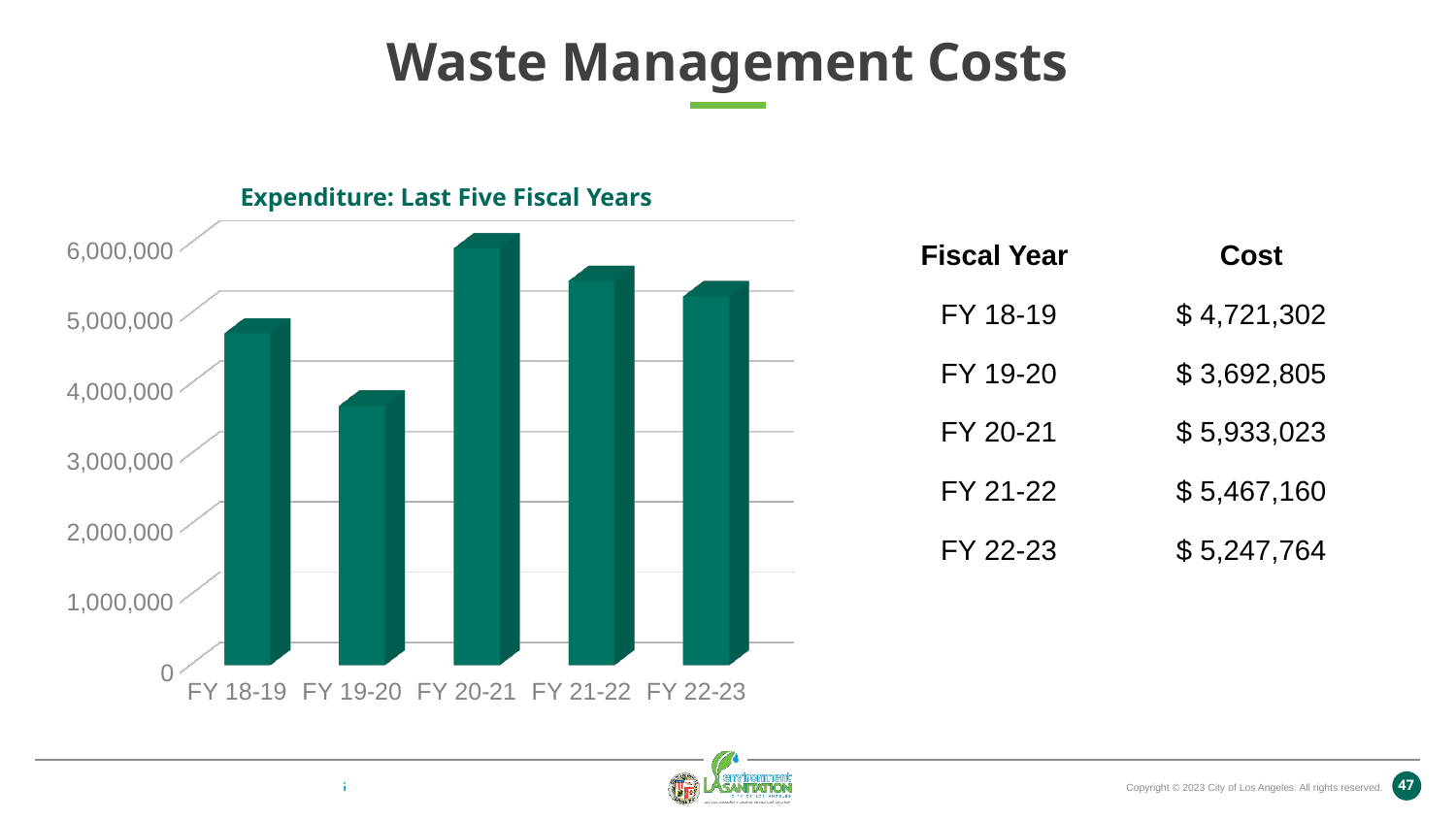
How many fiscal years are shown in the chart? 5 Which is larger, the expenditure for FY 18-19 or FY 21-22? FY 21-22 What type of chart is shown on the slide? Bar chart What is the difference in expenditure between FY 21-22 and FY 22-23? $ 219,396 What is the expenditure for FY 19-20? $ 3,692,805 Which fiscal year has the lowest expenditure? FY 19-20 Is the expenditure for FY 19-20 greater or less than 4,000,000? less What is the title of the chart? Expenditure: Last Five Fiscal Years What is the expenditure for FY 20-21? $ 5,933,023 Which fiscal year has the highest expenditure? FY 20-21 What is the difference in expenditure between FY 20-21 and FY 19-20? $ 2,240,218 What is the expenditure for FY 22-23? $ 5,247,764